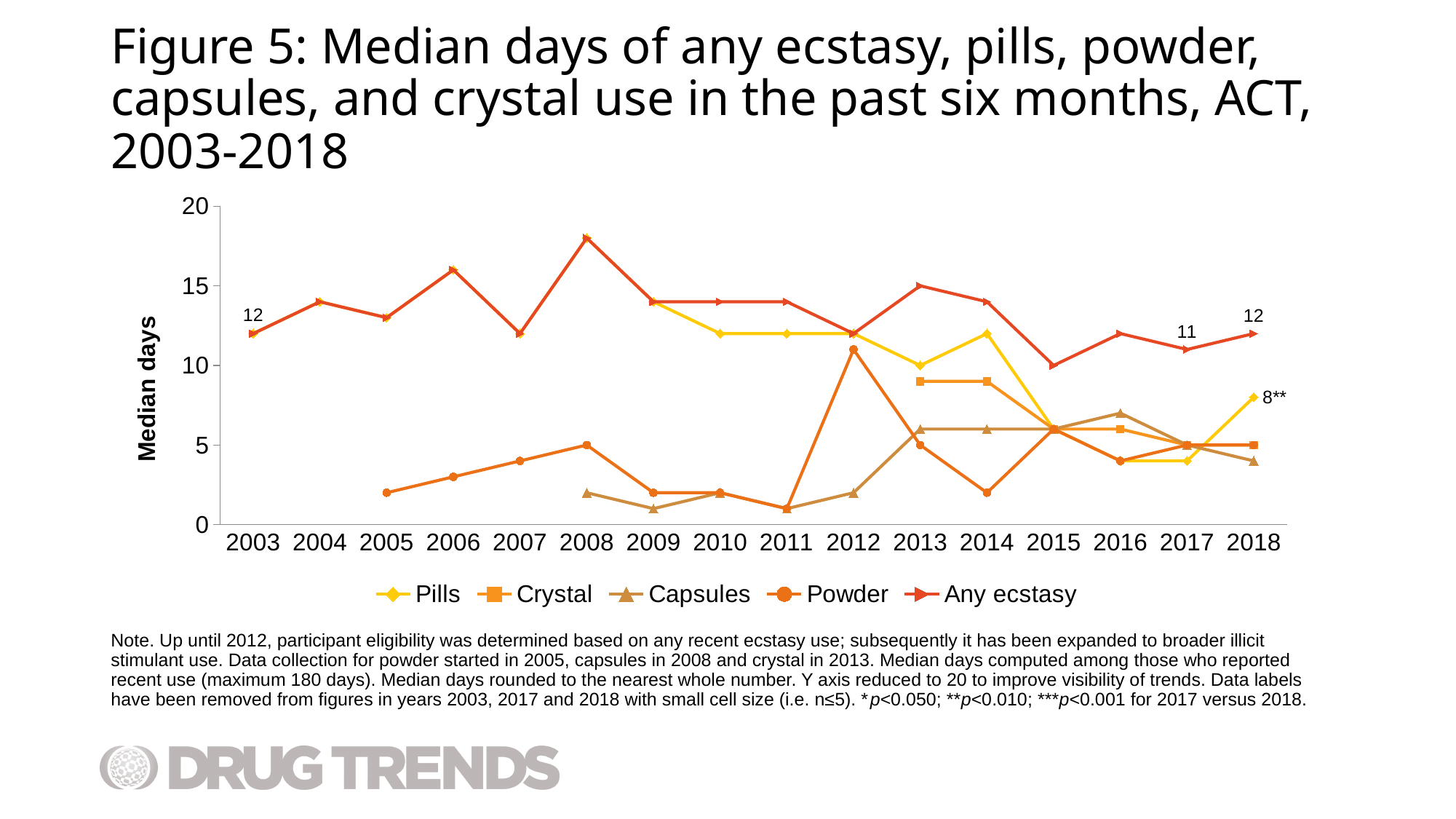
What kind of chart is shown on the slide? Line chart Is the value for Powder in 2005 greater or less than 5? less In which year is the Any ecstasy line at its highest? 2008 What is the median days value for Any ecstasy in 2003? 12 How many years are shown on the x axis? 16 By how much did the Any ecstasy median days change from 2017 to 2018? 1 What data label is shown for Pills in 2018? 8** What is the median days value for Any ecstasy in 2018? 12 Is the value for Any ecstasy in 2008 greater or less than 15? greater What is the title of the y axis? Median days How many series does the legend list? 5 What is the median days value for Any ecstasy in 2017? 11